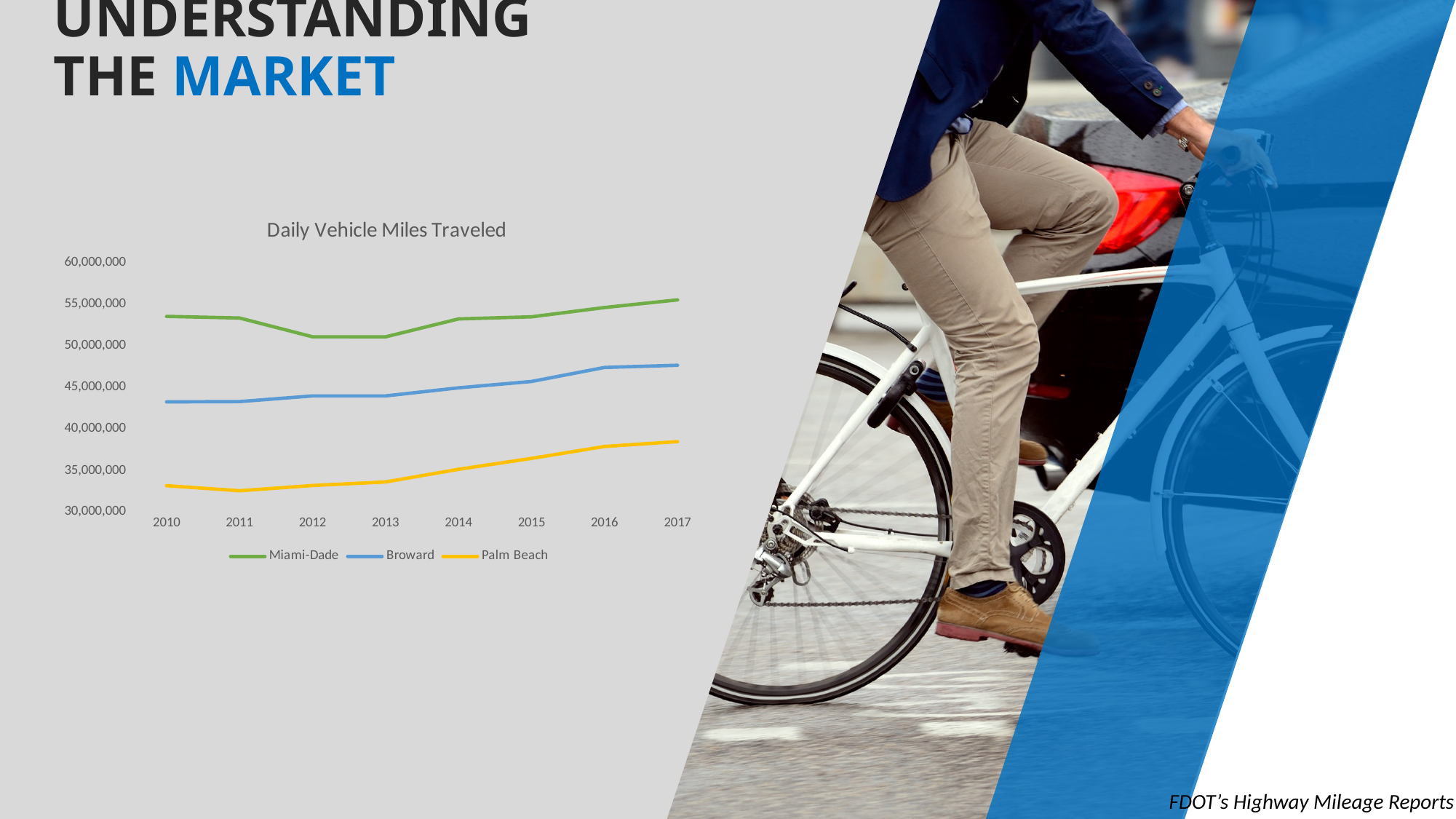
Is the value for Broward in 2010 greater or less than 45,000,000? less Is the value for Palm Beach in 2017 greater or less than 35,000,000? greater What kind of chart is shown on the slide? Line chart Which series has the highest daily vehicle miles traveled across all years shown? Miami-Dade In 2015, which is larger: the value for Miami-Dade or the value for Broward? Miami-Dade What is the title of the chart? Daily Vehicle Miles Traveled Is the value for Miami-Dade in 2012 greater or less than 55,000,000? less How many years are shown along the x axis of the chart? 8 Does the Broward line rise or fall from 2010 to 2017? Rises How many series does the chart's legend list? 3 Which series has the lowest daily vehicle miles traveled across all years shown? Palm Beach